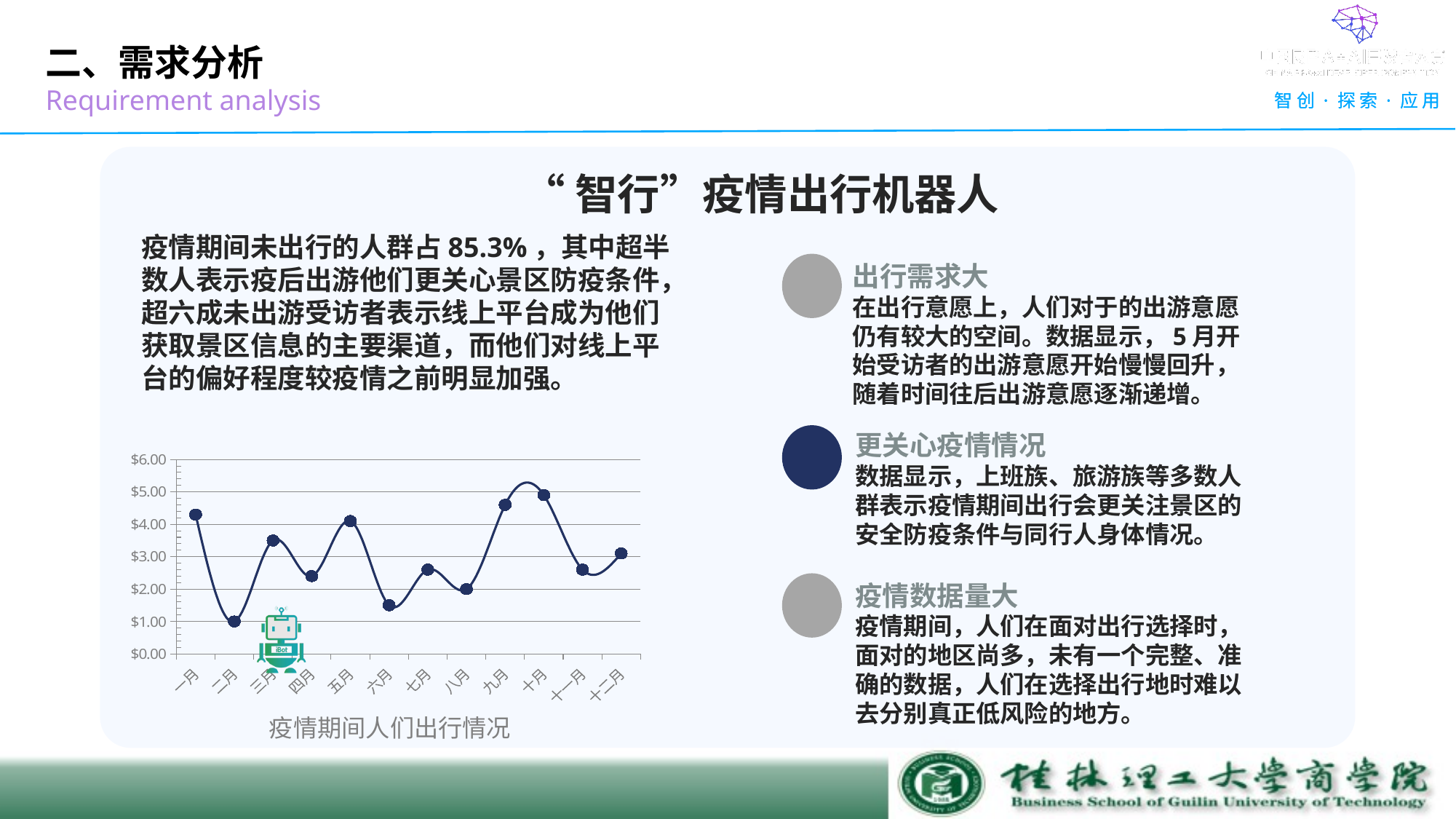
Is the value for 九月 greater or less than $4.00? greater What is the highest value shown on the y axis of the chart? $6.00 Is the value for 一月 greater or less than $4.00? greater What is the title shown below the chart? 疫情期间人们出行情况 Which month has the highest value in the chart? 十月 Is the value for 八月 greater or less than $3.00? less Which is larger, the value for 十二月 or the value for 十一月? 十二月 Which month has the lowest value in the chart? 二月 What kind of chart is shown on the slide? line chart Which is larger, the value for 五月 or the value for 四月? 五月 How many months are plotted along the x axis of the chart? 12